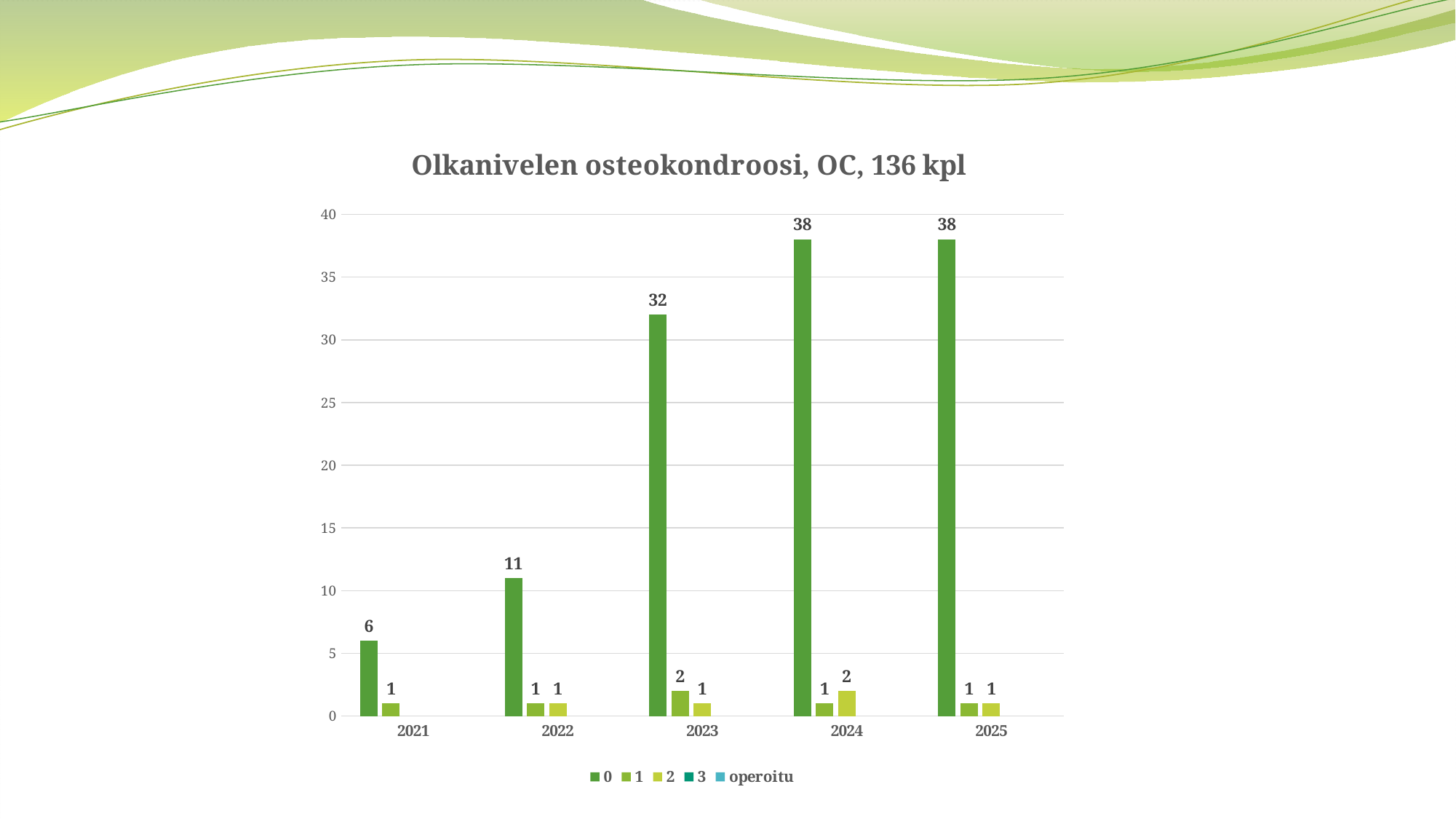
Does the value of series "0" rise or fall from 2021 to 2024? Rise Is the series "0" value for 2023 larger than the series "0" value for 2022? Yes What is the value of series "2" for 2024? 2 What is the value of series "0" for 2023? 32 Which year has the lowest value for series "0"? 2021 What is the title of the chart? Olkanivelen osteokondroosi, OC, 136 kpl What is the value of series "1" for 2021? 1 How many series does the legend list? 5 How many years are shown on the x axis? 5 Is the value of series "0" for 2025 greater or less than 35? greater What kind of chart is shown on the slide? Bar chart What is the difference between the series "0" values for 2024 and 2022? 27